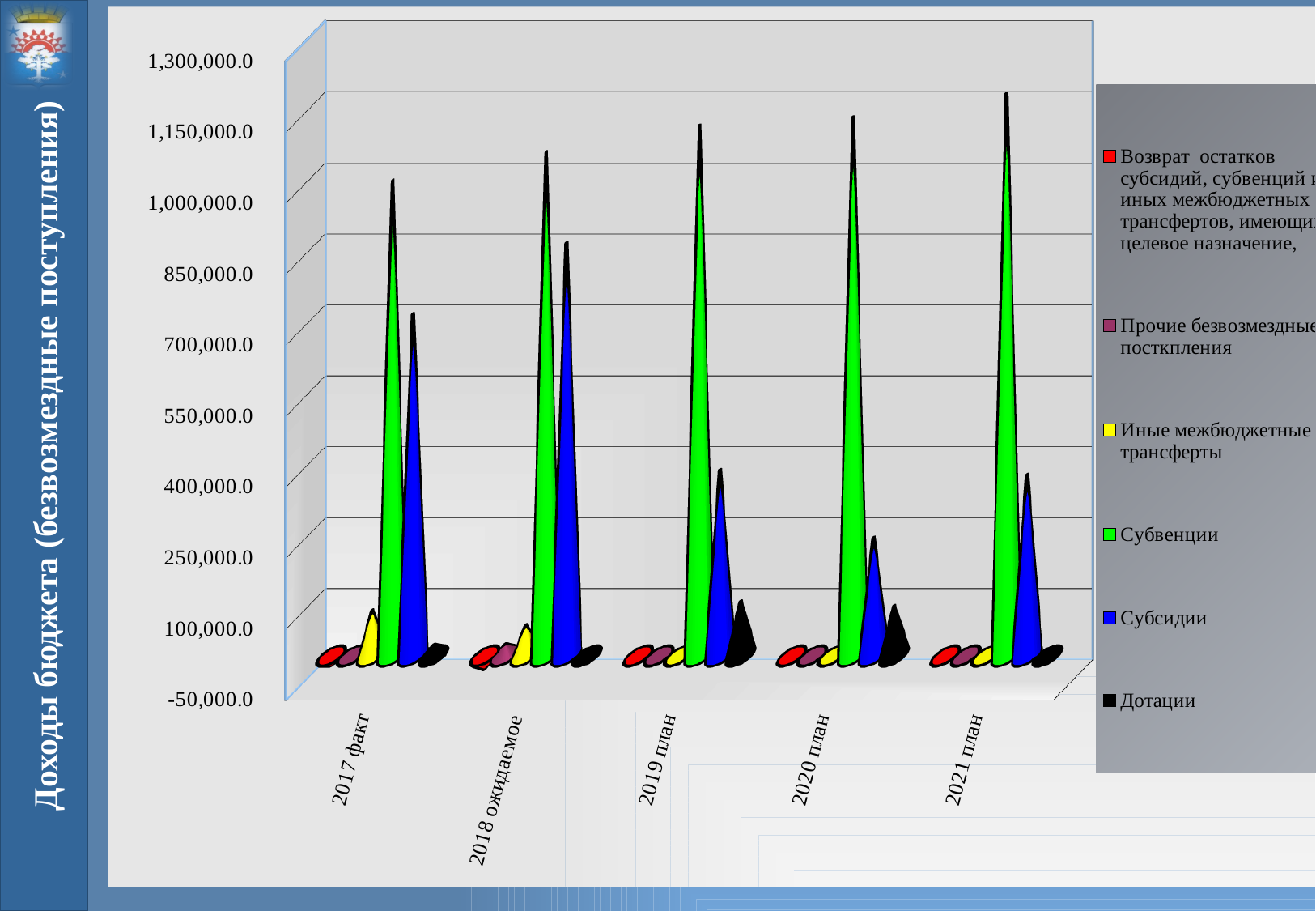
Do the values for Субвенции rise or fall from 2017 факт to 2021 план? rise What kind of chart is shown on the slide? bar chart Is the value for Дотации in 2019 план greater or less than 250,000.0? less Is the value for Субвенции in 2019 план greater or less than 1,000,000.0? greater Which category has the highest value for Субвенции? 2021 план Which category has the lowest value for Субсидии? 2020 план How many series does the legend list? 6 How many categories are shown along the x axis? 5 Is the value for Субсидии in 2020 план greater or less than 400,000.0? less Which colour represents Субвенции in the legend? green In 2019 план, which is larger: Субвенции or Субсидии? Субвенции